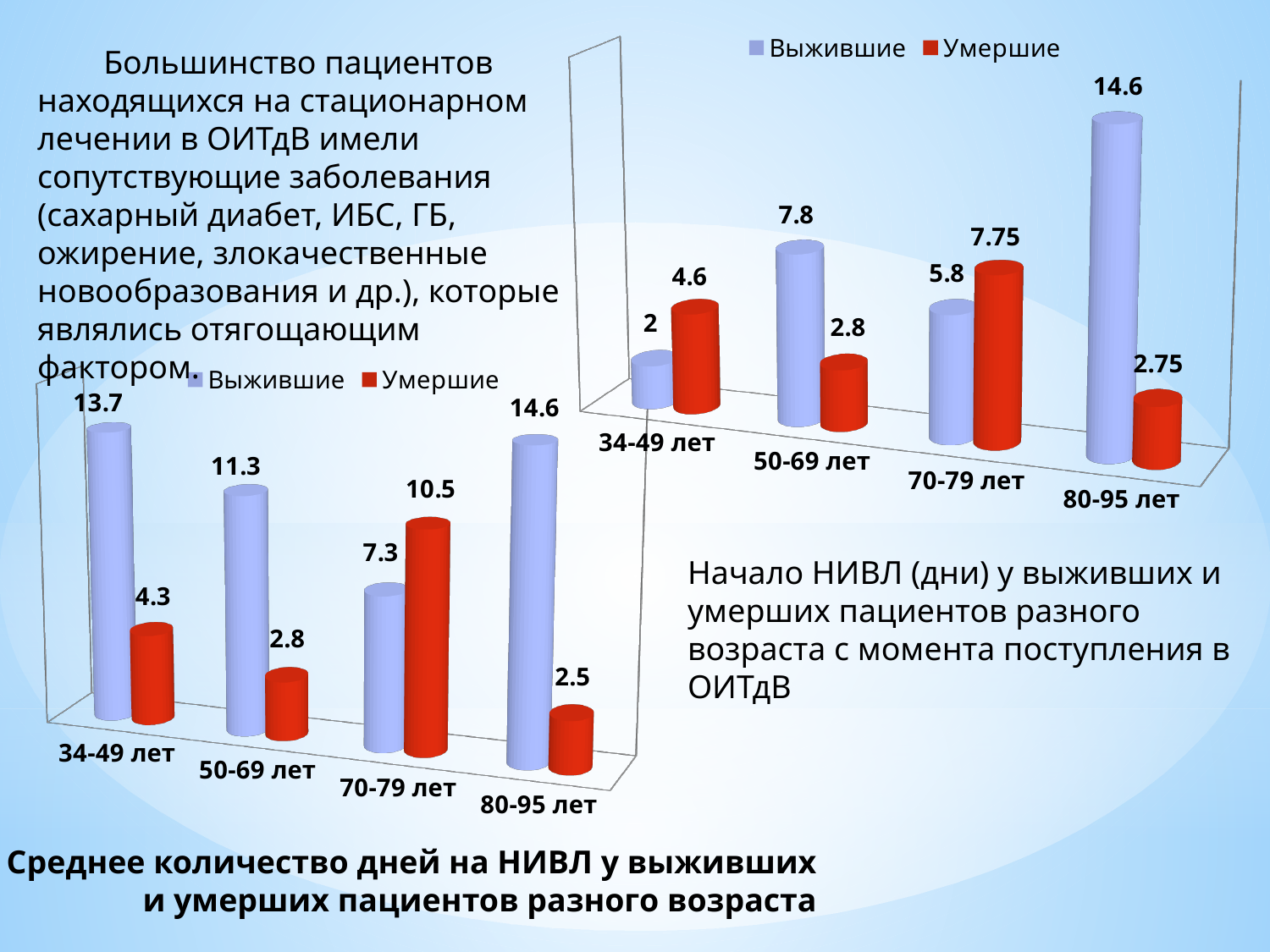
In the bottom-left chart, what is the value for Выжившие in the 34-49 лет group? 13.7 In the bottom-left chart, what is the value for Умершие in the 70-79 лет group? 10.5 In the bottom-left chart, which age group has the highest value for Выжившие? 80-95 лет In the top-right chart, what is the difference between Выжившие and Умершие in the 80-95 лет group? 11.85 In the top-right chart, which age group has the lowest value for Выжившие? 34-49 лет How many series does the legend of the top-right chart list? 2 In the bottom-left chart, what is the difference between Выжившие and Умершие in the 50-69 лет group? 8.5 In the top-right chart, what is the value for Выжившие in the 50-69 лет group? 7.8 What type of chart is the bottom-left chart? Bar chart In the top-right chart, what is the value for Умершие in the 70-79 лет group? 7.75 In the bottom-left chart, which is larger in the 70-79 лет group, Выжившие or Умершие? Умершие In the bottom-left chart, which age group has the lowest value for Умершие? 80-95 лет